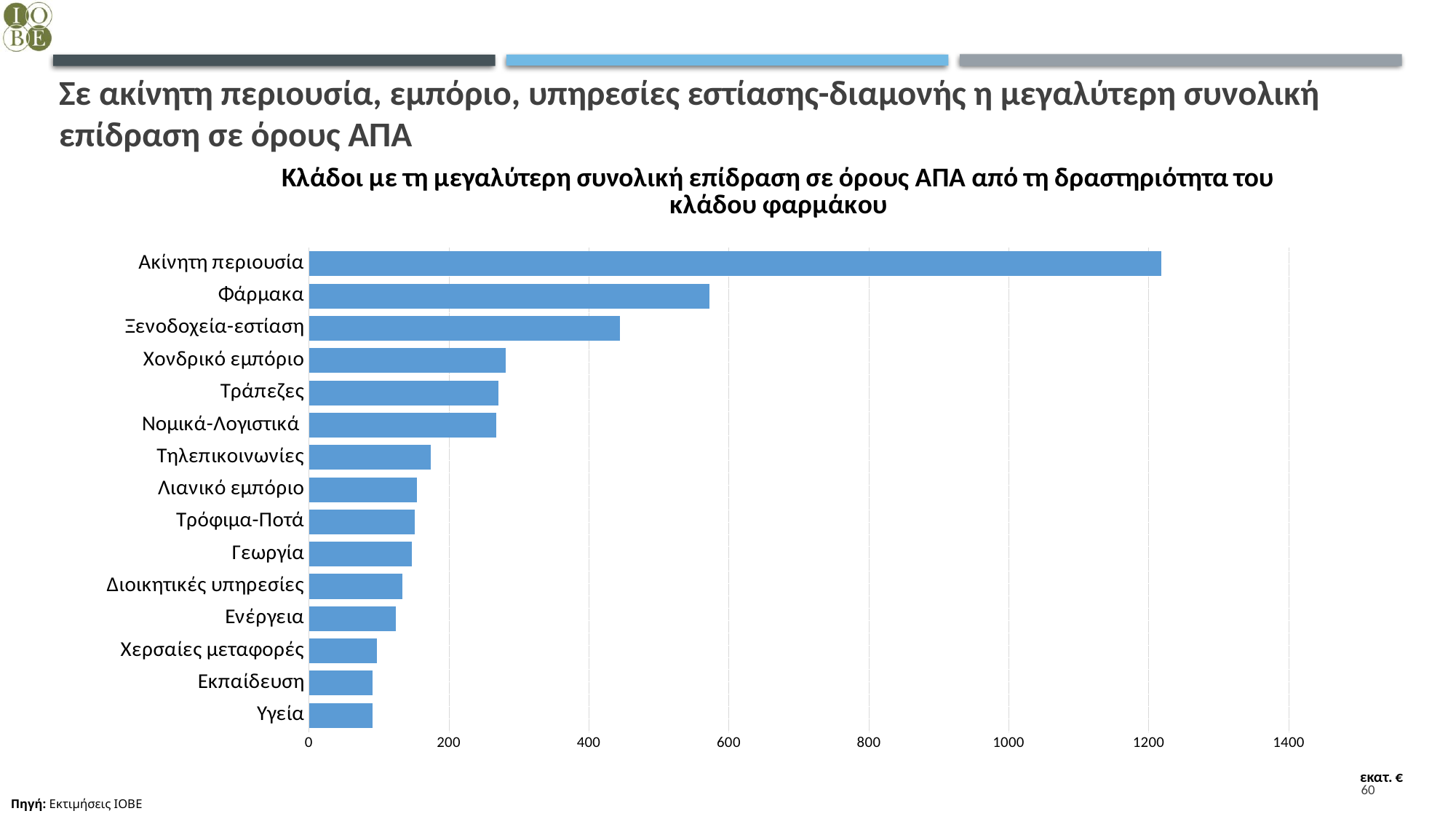
Which has a larger value, Χονδρικό εμπόριο or Ενέργεια? Χονδρικό εμπόριο What is the title of the chart? Κλάδοι με τη μεγαλύτερη συνολική επίδραση σε όρους ΑΠΑ από τη δραστηριότητα του κλάδου φαρμάκου Is the value for Φάρμακα greater or less than 600? less Is the value for Ακίνητη περιουσία greater or less than 1200? greater Which has a larger value, Φάρμακα or Ξενοδοχεία-εστίαση? Φάρμακα Is the value for Τηλεπικοινωνίες greater or less than 200? less What unit is indicated for the values in the chart? εκατ. € Which sector has the highest value in the chart? Ακίνητη περιουσία What kind of chart is shown on the slide? bar chart How many categories (sectors) are plotted in the chart? 15